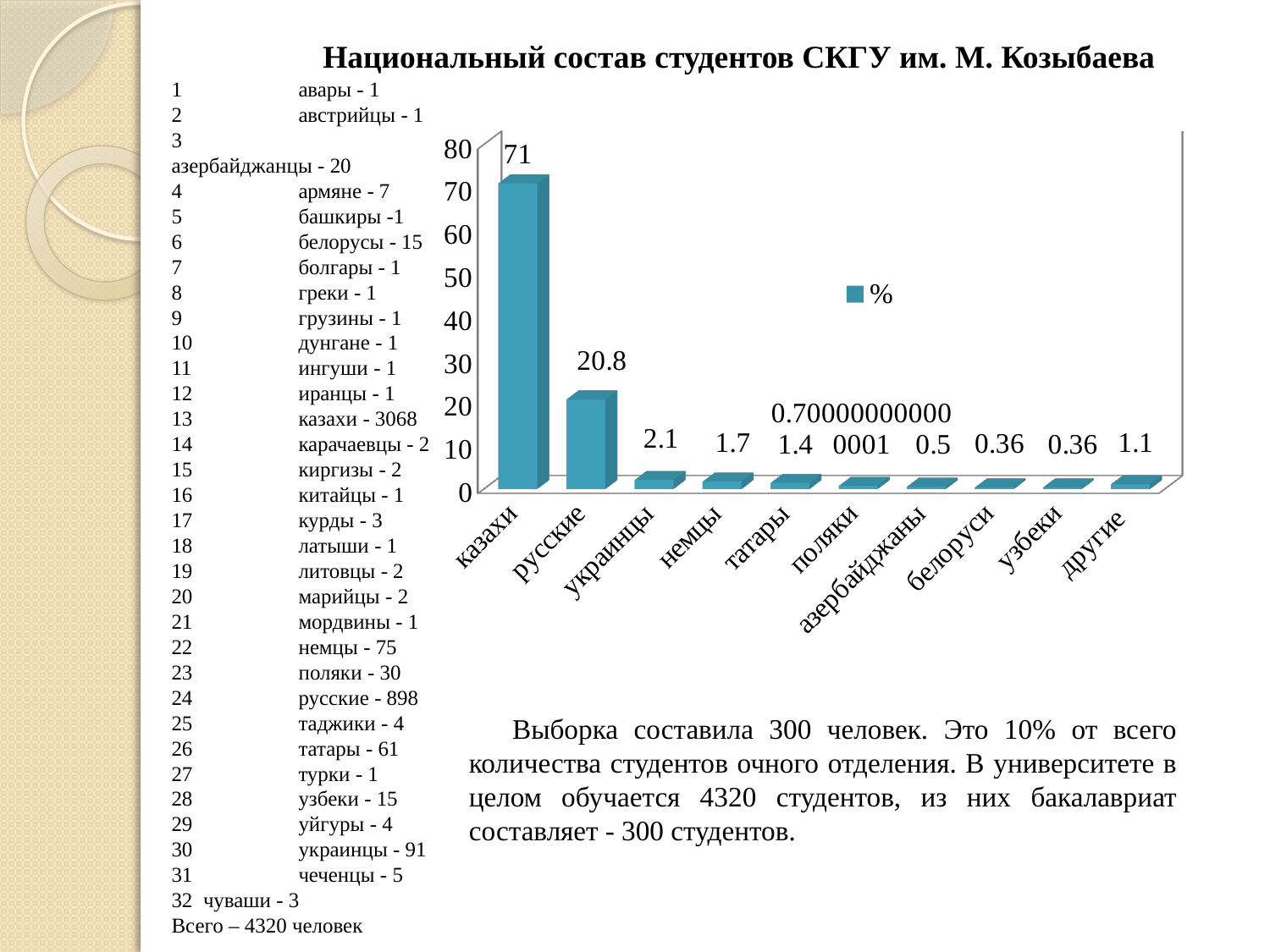
Which is larger, the value for татары or the value for другие? татары What is the value for русские in the chart? 20.8 What is the value for украинцы in the chart? 2.1 How many series does the chart legend list? 1 What is the value for немцы in the chart? 1.7 What kind of chart is shown on the slide? bar chart How many categories are shown on the x axis of the chart? 10 Which category has the highest value in the chart? казахи What is the difference between the values for казахи and русские? 50.2 What is the value for другие in the chart? 1.1 What is the value for казахи in the chart? 71 What is the value for азербайджаны in the chart? 0.5